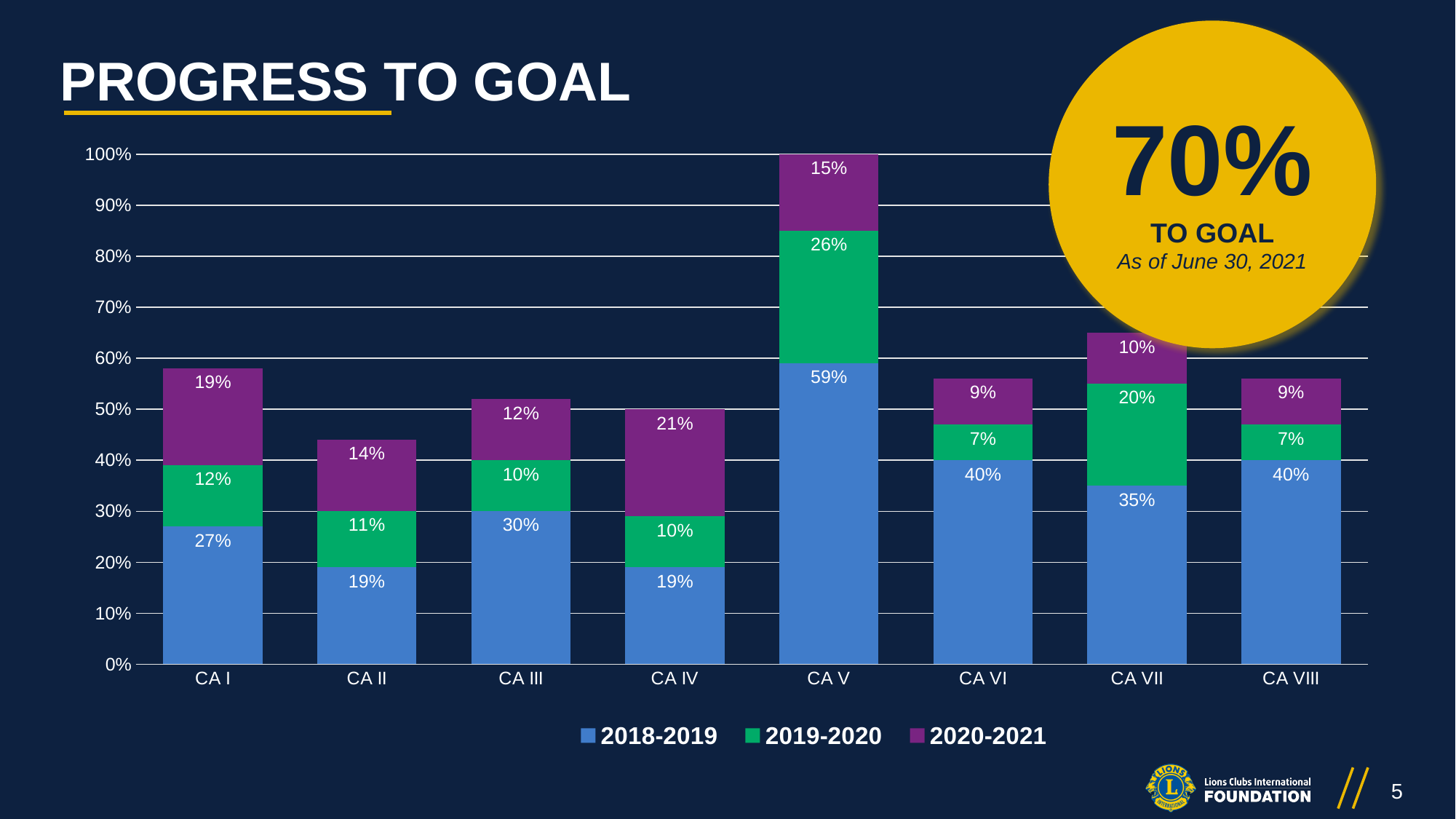
What is the difference between the 2018-2019 values for CA V and CA III? 29% What is the 2020-2021 value for CA IV? 21% What is the total of the stacked bar for CA VII? 65% Which category has the lowest 2019-2020 value? CA VI and CA VIII What kind of chart is shown on the slide? Stacked bar chart What is the total of the stacked bar for CA II? 44% What is the 2019-2020 value for CA VII? 20% Which category has the highest 2018-2019 value? CA V Which is larger, the 2020-2021 value for CA I or for CA II? CA I How many series does the legend list? 3 How many categories are shown on the x axis? 8 What is the 2018-2019 value for CA V? 59%